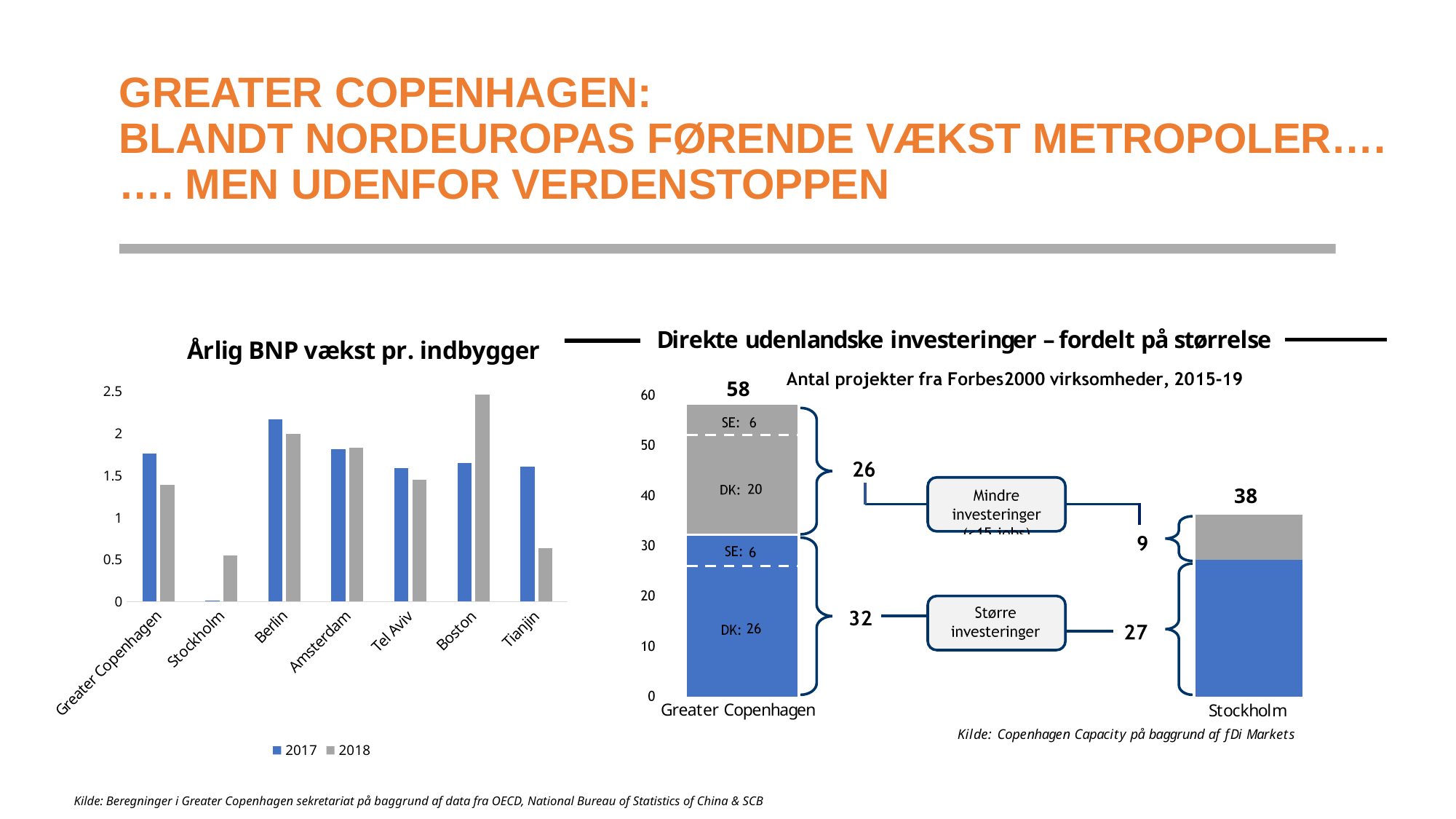
In the chart 'Direkte udenlandske investeringer – fordelt på størrelse', how many 'Større investeringer' projects does Greater Copenhagen have? 32 In the chart 'Årlig BNP vækst pr. indbygger', which is larger for Greater Copenhagen, the 2017 value or the 2018 value? 2017 In the chart 'Årlig BNP vækst pr. indbygger', which city has the highest 2018 value? Boston In the chart 'Årlig BNP vækst pr. indbygger', which city has the lowest 2017 value? Stockholm In the chart 'Årlig BNP vækst pr. indbygger', how many series does the legend list? 2 What kind of chart is 'Årlig BNP vækst pr. indbygger'? Bar chart In the chart 'Årlig BNP vækst pr. indbygger', is the 2018 value for Stockholm greater or less than 1? less In the chart 'Direkte udenlandske investeringer – fordelt på størrelse', what is the total number of projects for Greater Copenhagen? 58 In the chart 'Årlig BNP vækst pr. indbygger', is the 2017 value for Berlin greater or less than 2? greater In the chart 'Direkte udenlandske investeringer – fordelt på størrelse', what is the total number of projects for Stockholm? 38 In the chart 'Årlig BNP vækst pr. indbygger', how many cities are shown on the x axis? 7 In the chart 'Direkte udenlandske investeringer – fordelt på størrelse', what is the difference between the totals for Greater Copenhagen and Stockholm? 20